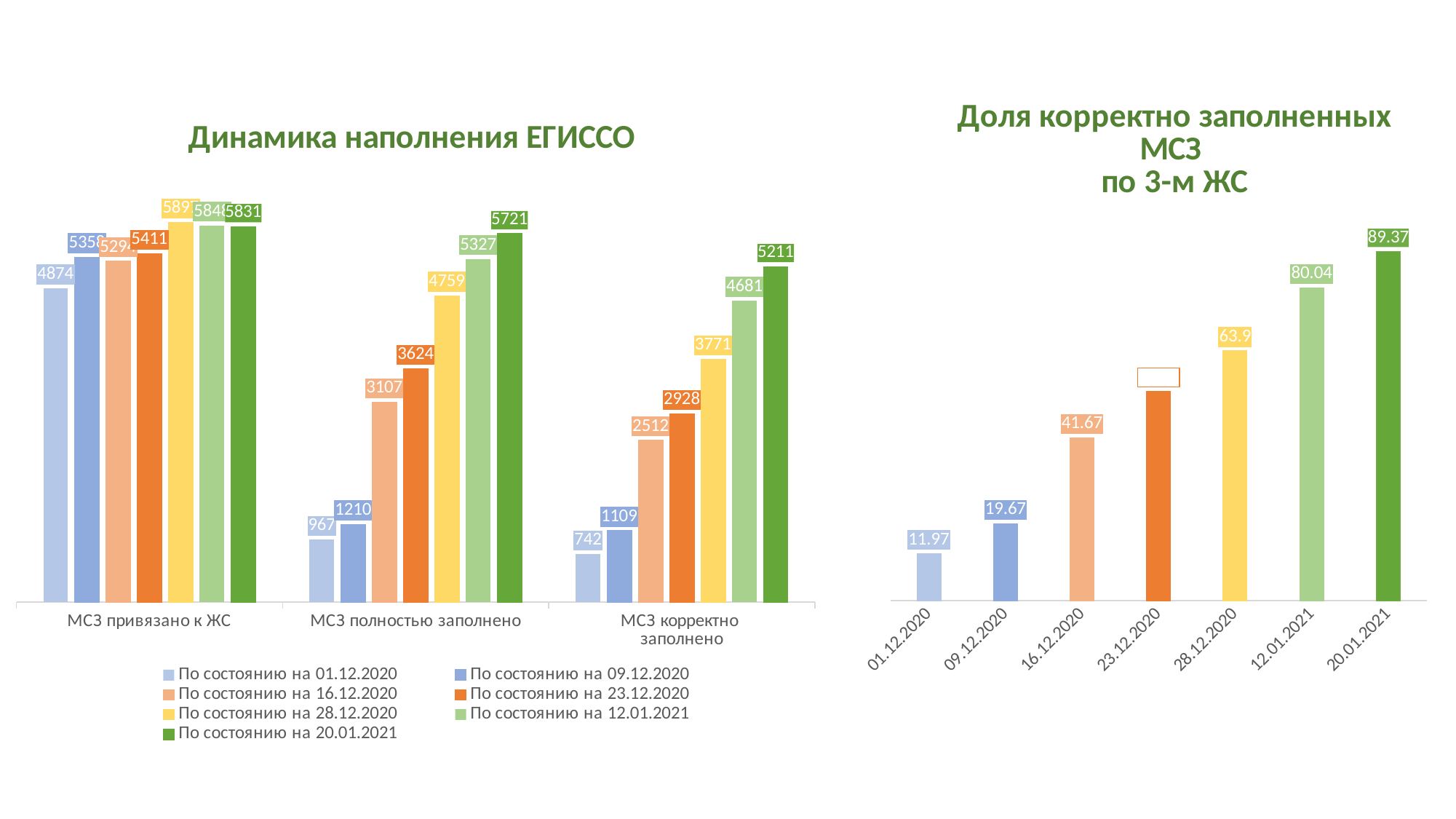
How many series does the legend of the chart 'Динамика наполнения ЕГИССО' list? 7 In the chart 'Динамика наполнения ЕГИССО', what is the value for 'МСЗ привязано к ЖС' as of 09.12.2020? 5358 In the chart 'Доля корректно заполненных МСЗ по 3-м ЖС', what is the value for 20.01.2021? 89.37 In the chart 'Динамика наполнения ЕГИССО', what is the value for 'МСЗ корректно заполнено' as of 01.12.2020? 742 In the chart 'Динамика наполнения ЕГИССО', what is the difference between the 20.01.2021 and 12.01.2021 values for 'МСЗ полностью заполнено'? 394 What kind of chart is 'Доля корректно заполненных МСЗ по 3-м ЖС'? Bar chart In the chart 'Доля корректно заполненных МСЗ по 3-м ЖС', do the values rise or fall from 01.12.2020 to 20.01.2021? Rise In the chart 'Динамика наполнения ЕГИССО', what is the value for 'МСЗ полностью заполнено' as of 20.01.2021 (По состоянию на 20.01.2021)? 5721 How many categories are shown on the x axis of the chart 'Динамика наполнения ЕГИССО'? 3 In the chart 'Доля корректно заполненных МСЗ по 3-м ЖС', which date has the lowest value? 01.12.2020 In the chart 'Доля корректно заполненных МСЗ по 3-м ЖС', what is the difference between the values for 12.01.2021 and 28.12.2020? 16.14 In the chart 'Динамика наполнения ЕГИССО', which is larger for 'МСЗ корректно заполнено': the value as of 16.12.2020 or as of 23.12.2020? 23.12.2020 (2928)